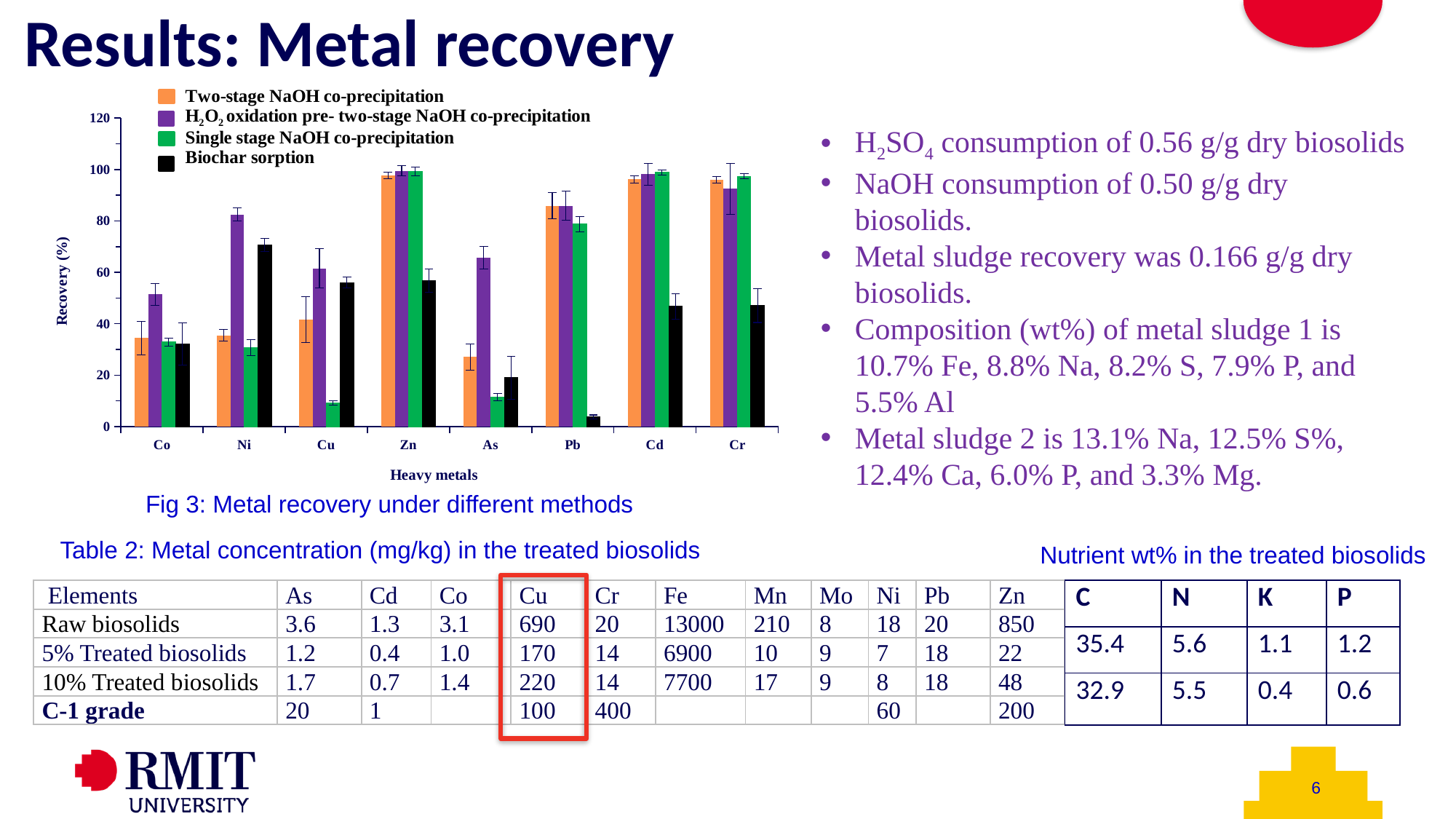
In the metal recovery chart, is the Single stage NaOH co-precipitation recovery for Cu greater or less than 20? less In the metal recovery chart, which method has the lowest recovery for Pb? Biochar sorption In the metal recovery chart, which method gives the higher recovery for Ni: Biochar sorption or Two-stage NaOH co-precipitation? Biochar sorption In the metal recovery chart, which method gives the higher recovery for Cu: H2O2 oxidation pre- two-stage NaOH co-precipitation or Single stage NaOH co-precipitation? H2O2 oxidation pre- two-stage NaOH co-precipitation What is the y-axis label of the metal recovery chart? Recovery (%) How many series does the legend of the metal recovery chart list? 4 In the metal recovery chart, is the H2O2 oxidation pre- two-stage NaOH co-precipitation recovery for Ni greater or less than 60? greater In the metal recovery chart, which method has the highest recovery for As? H2O2 oxidation pre- two-stage NaOH co-precipitation In the metal recovery chart, is the Two-stage NaOH co-precipitation recovery for Zn greater or less than 80? greater How many heavy metals are shown on the x axis of the metal recovery chart? 8 What kind of chart is Fig 3 (Metal recovery under different methods)? bar chart